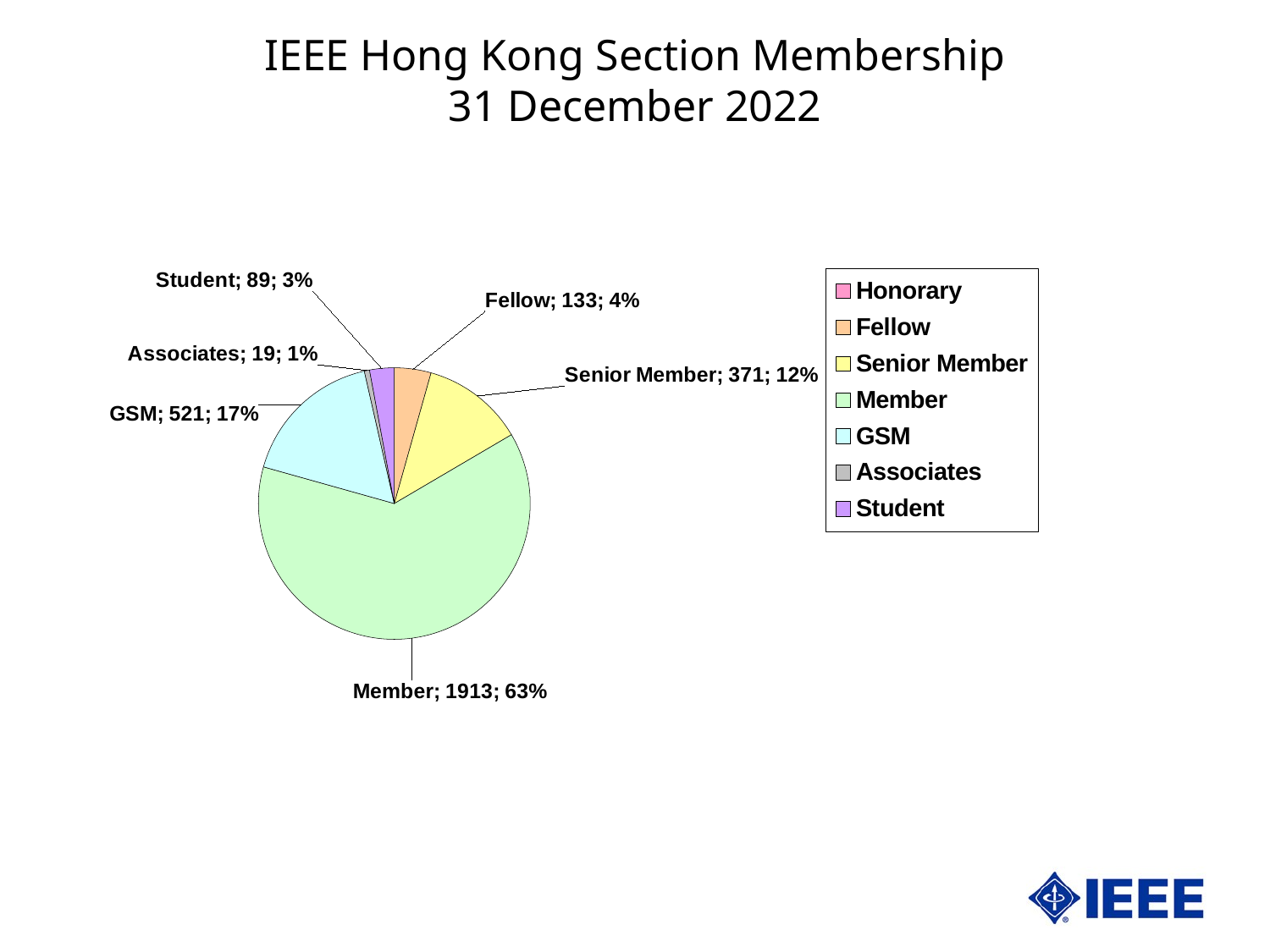
Which category has the largest slice of the pie? Member What is the difference between the Senior Member count and the Fellow count? 238 Which is larger, the GSM count or the Senior Member count? GSM What share of the pie is the Fellow slice? 4% What is the value shown for GSM? 521 How many entries does the legend list? 7 What is the value shown for Student? 89 Which labelled category has the smallest slice of the pie? Associates How many members does the Member category have? 1913 What is the title of the chart? IEEE Hong Kong Section Membership 31 December 2022 What percentage of the pie does Senior Member represent? 12% What kind of chart is shown on the slide? pie chart